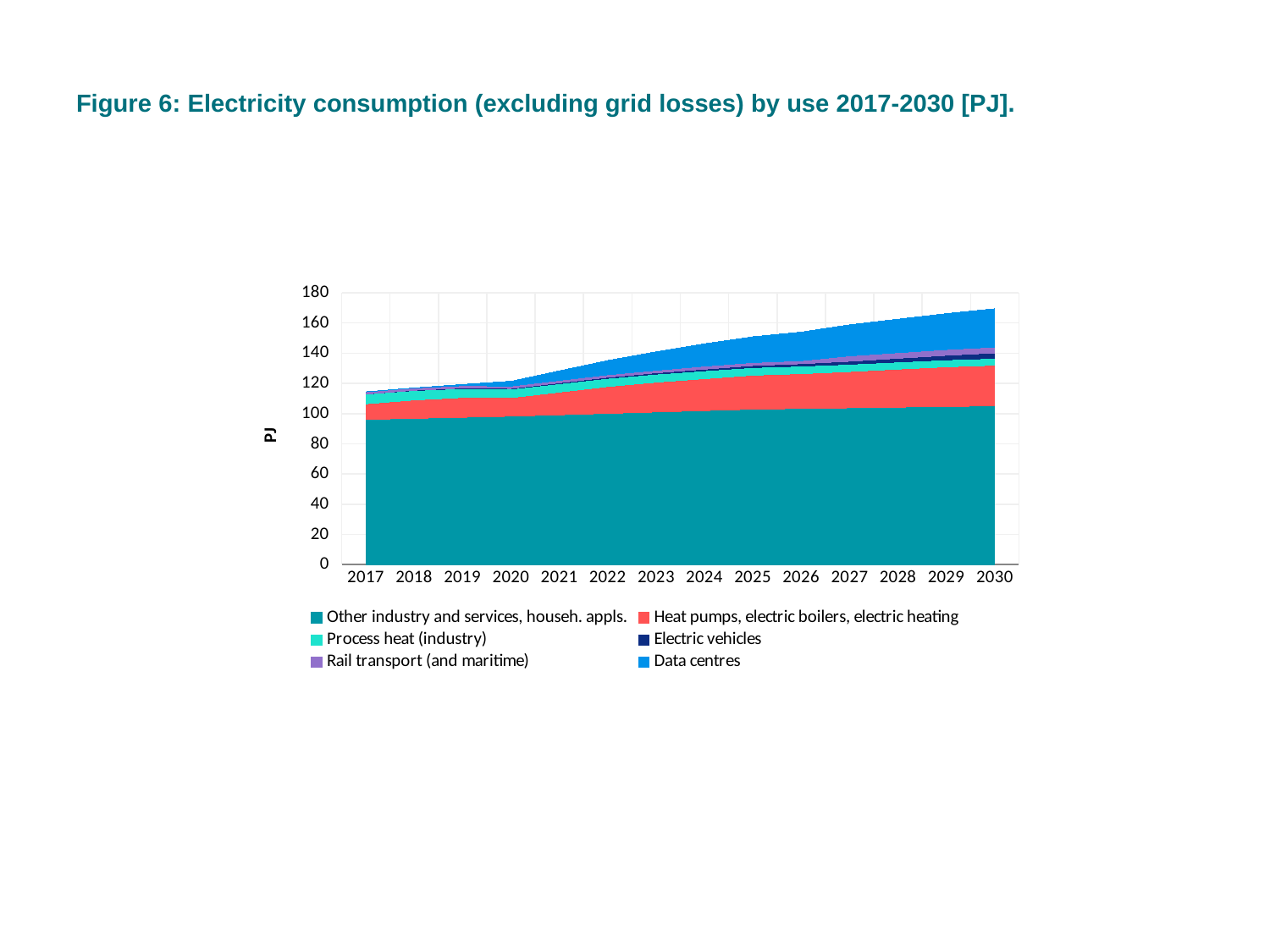
Is the value for 'Other industry and services, househ. appls.' in 2030 greater or less than 100 PJ? greater How many series does the legend list? 6 What is the title of the chart? Figure 6: Electricity consumption (excluding grid losses) by use 2017-2030 [PJ]. Which is larger in 2030: the consumption of 'Data centres' or of 'Electric vehicles'? Data centres Is the value for 'Other industry and services, househ. appls.' in 2017 greater or less than 100 PJ? less What unit is shown on the y axis label? PJ Does total electricity consumption rise or fall from 2017 to 2030? Rises Is the total electricity consumption in 2030 greater or less than 160 PJ? greater How many years are shown along the x axis? 14 Which series accounts for the largest share of electricity consumption in 2030? Other industry and services, househ. appls. What kind of chart is shown on the slide? Stacked area chart